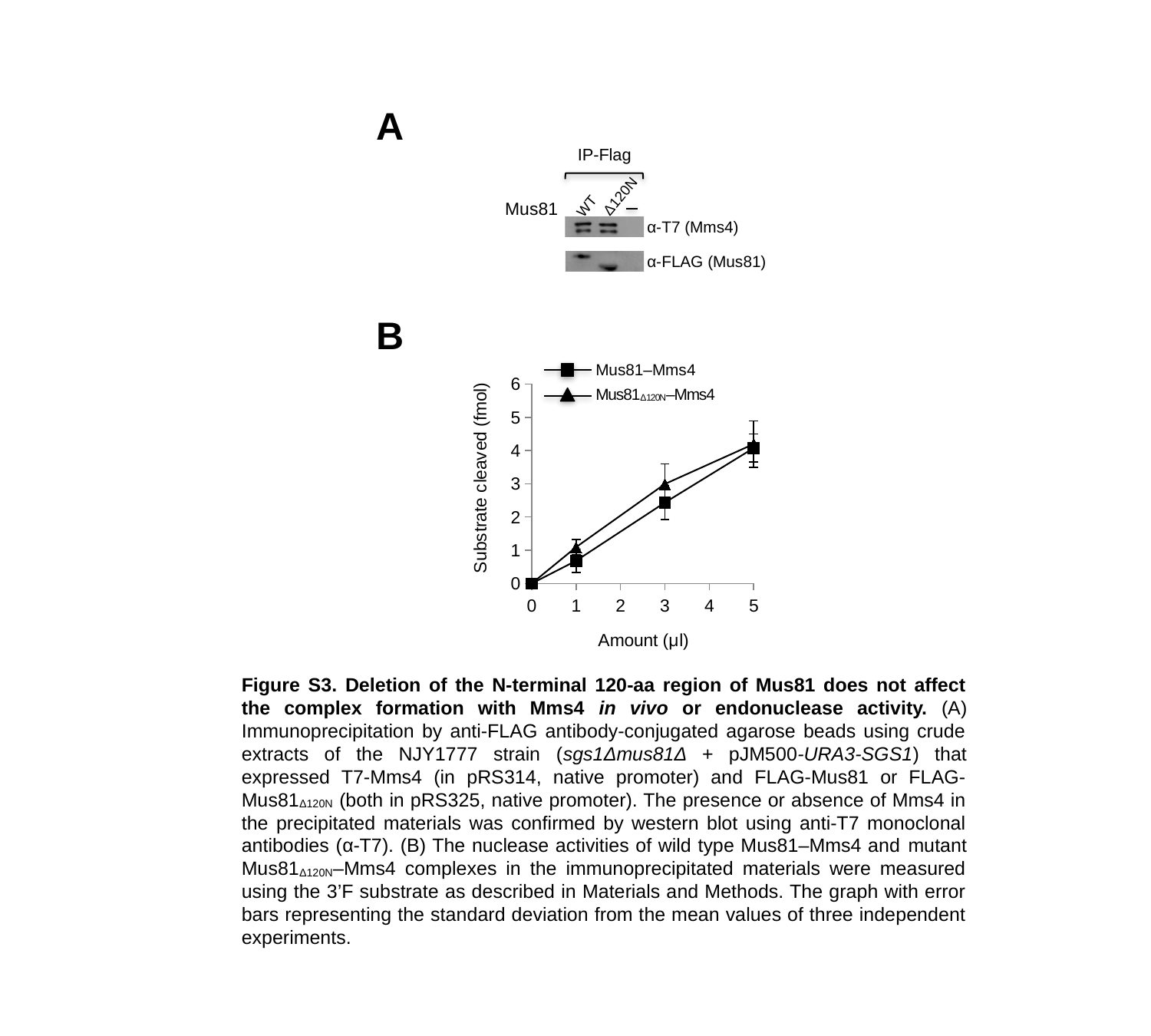
In the chart in panel B, at 3 µl, which series has the larger value, Mus81–Mms4 or Mus81Δ120N–Mms4? Mus81Δ120N–Mms4 In the chart in panel B, is the Mus81–Mms4 value at 3 µl greater or less than 2? greater In the chart in panel B, does the substrate cleaved for Mus81–Mms4 rise or fall as the amount increases? rise In the chart in panel B, is the Mus81–Mms4 value at 5 µl greater or less than 5? less In the chart in panel B, at which amount is the Mus81Δ120N–Mms4 value lowest? 0 µl In the chart in panel B, how many series does the legend list? 2 In the chart in panel B, which marker shape is used for the Mus81–Mms4 series? square What is the y-axis title of the chart in panel B? Substrate cleaved (fmol) In the chart in panel B, at which amount is the Mus81–Mms4 value highest? 5 µl In the chart in panel B, how many data points are plotted for the Mus81–Mms4 series? 4 In the chart in panel B, is the Mus81Δ120N–Mms4 value at 1 µl greater or less than 2? less What kind of chart is shown in panel B? line chart